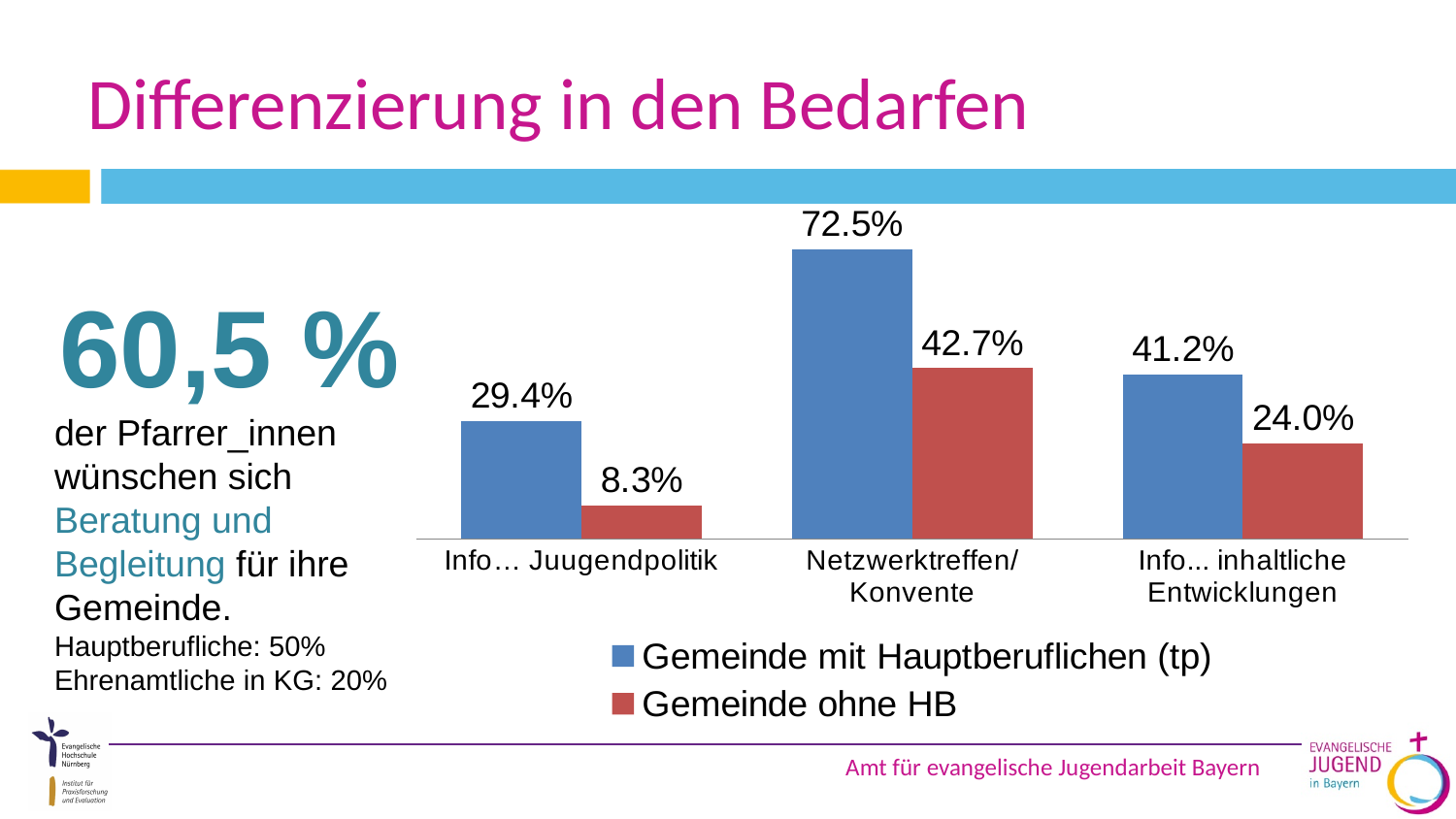
Which category has the highest value for "Gemeinde mit Hauptberuflichen (tp)"? Netzwerktreffen/ Konvente What is the value for "Gemeinde ohne HB" in the category "Info... inhaltliche Entwicklungen"? 24.0% What kind of chart is shown on the slide? bar chart What is the difference between the two series in the category "Netzwerktreffen/ Konvente"? 29.8% Which category has the lowest value for "Gemeinde ohne HB"? Info… Juugendpolitik Which is larger: the "Gemeinde ohne HB" value for "Netzwerktreffen/ Konvente" or the "Gemeinde mit Hauptberuflichen (tp)" value for "Info... inhaltliche Entwicklungen"? Gemeinde ohne HB for Netzwerktreffen/ Konvente How many categories are shown on the x axis? 3 What is the difference between the "Gemeinde mit Hauptberuflichen (tp)" values for "Info... inhaltliche Entwicklungen" and "Info… Juugendpolitik"? 11.8% What is the value for "Gemeinde ohne HB" in the category "Info… Juugendpolitik"? 8.3% How many series does the legend list? 2 Which colour represents the series "Gemeinde ohne HB" in the legend? red What is the value for "Gemeinde mit Hauptberuflichen (tp)" in the category "Netzwerktreffen/ Konvente"? 72.5%